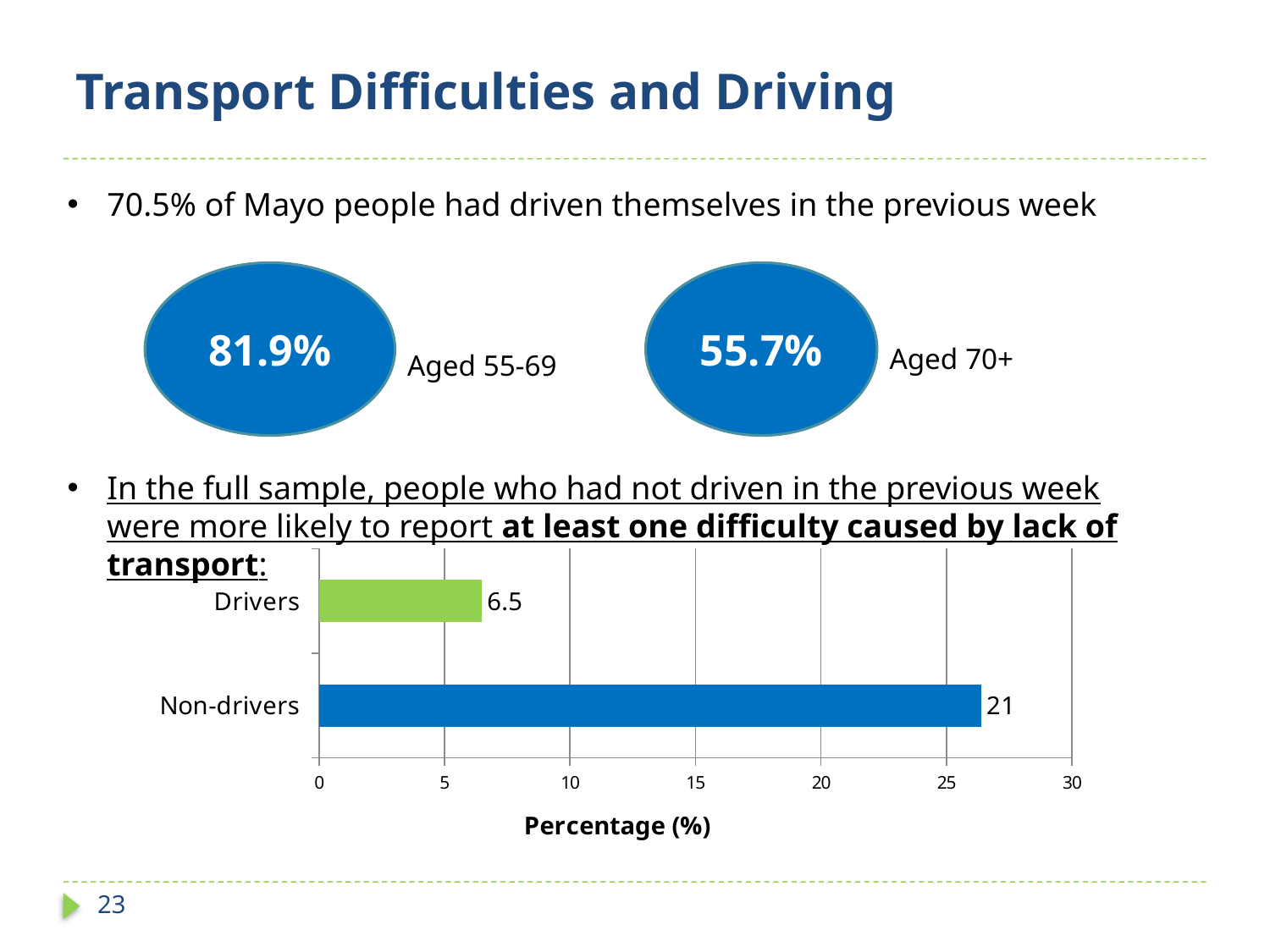
What is the difference between the Non-drivers and Drivers values in the bar chart? 14.5 What is the value for Non-drivers in the bar chart? 21 What is the value for Drivers in the bar chart? 6.5 Is the value for Non-drivers in the bar chart greater or less than 20? greater How many categories are shown in the bar chart? 2 Which category has the higher value in the bar chart, Drivers or Non-drivers? Non-drivers What kind of chart is shown on the slide? Bar chart What colour is the Drivers bar in the chart? Green Which category has the highest value in the bar chart? Non-drivers Which category has the lowest value in the bar chart? Drivers What is the title of the x axis of the bar chart? Percentage (%) Is the value for Drivers in the bar chart greater or less than 10? less